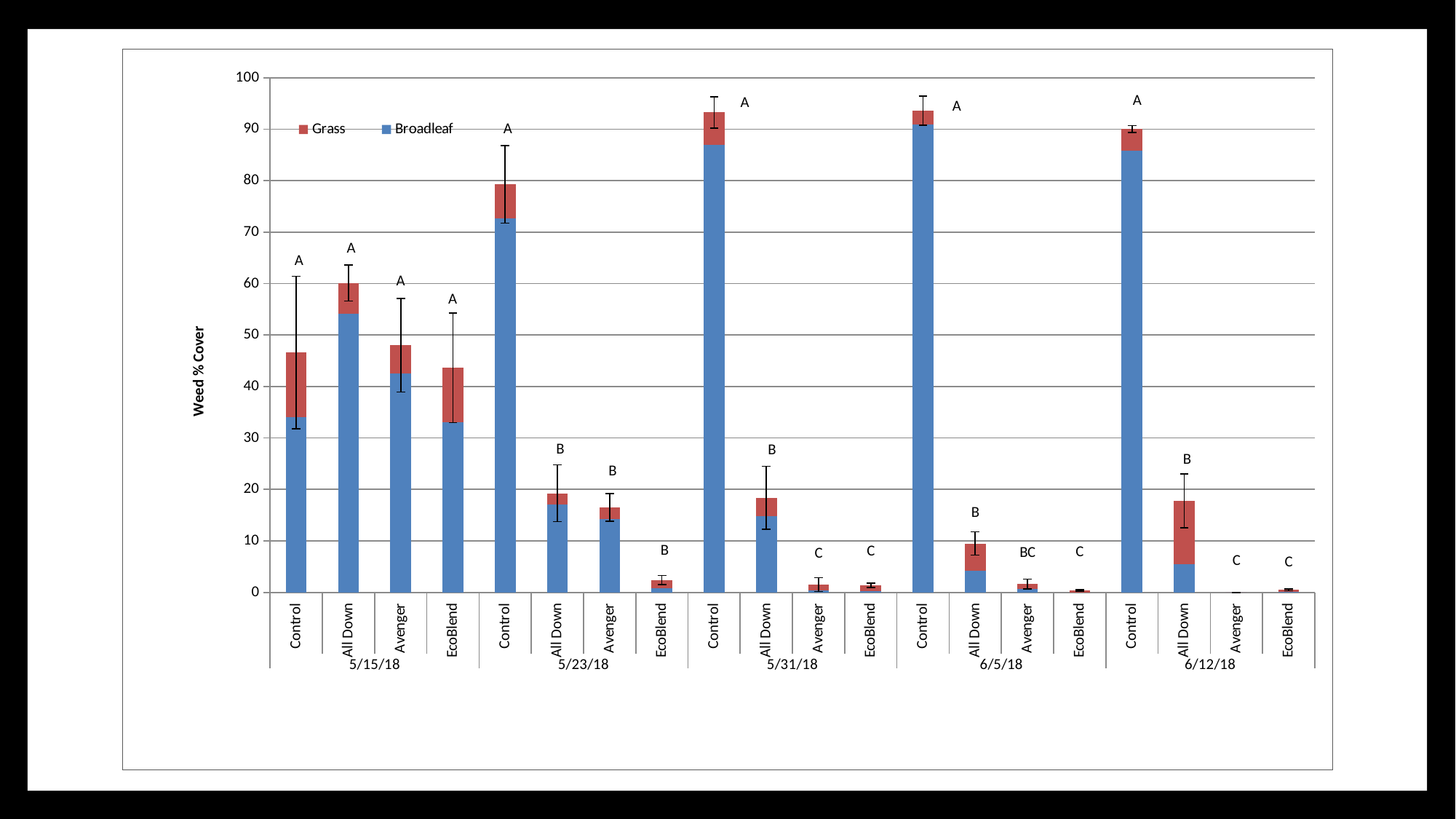
Is the total value for Control on 5/23/18 greater or less than 70? greater Among the treatments on 5/15/18, which has the highest total weed % cover? All Down What is the title of the y axis? Weed % Cover How many dates are shown along the x axis? 5 What kind of chart is shown on the slide? Stacked bar chart Is the total value for All Down on 6/12/18 greater or less than 10? greater Among the treatments on 5/23/18, which has the lowest total weed % cover? EcoBlend How many series does the legend list? 2 Which is larger: the total for All Down on 5/31/18 or the total for All Down on 6/5/18? All Down on 5/31/18 Is the total value for EcoBlend on 5/23/18 greater or less than 10? less How many bars are plotted in total on the chart? 20